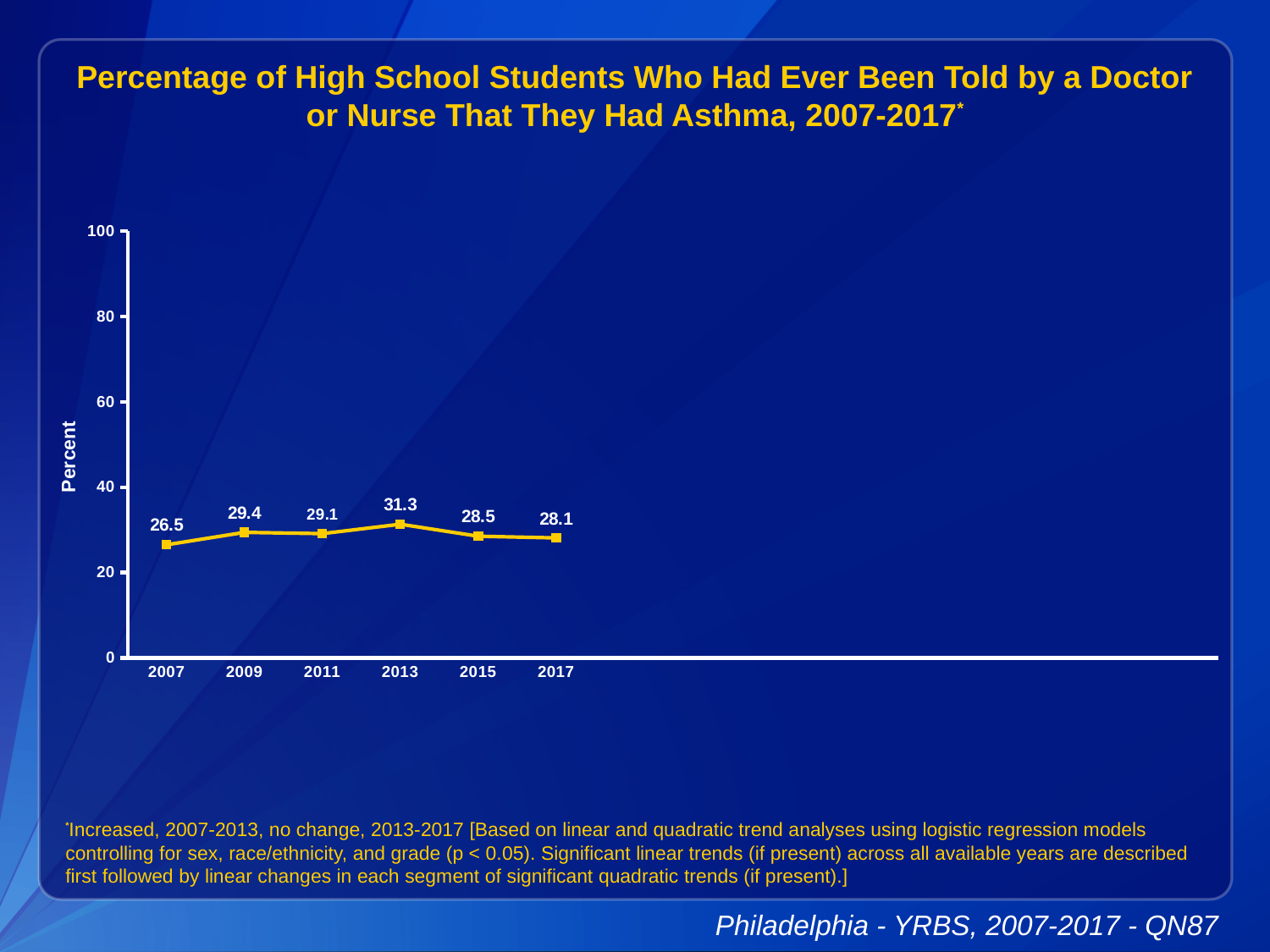
What is the difference between the 2013 value and the 2007 value? 4.8 How many years are plotted on the chart? 6 What was the percentage of high school students who had ever been told they had asthma in 2007? 26.5 Which year has the lowest value? 2007 Which year has the highest value? 2013 Which is larger, the value for 2009 or the value for 2015? 2009 What value is shown for 2013? 31.3 Did the value rise or fall from 2013 to 2017? fall What kind of chart is shown on the slide? line chart Is the value for 2013 greater or less than 40? less What value is shown for 2017? 28.1 What is the label on the y axis? Percent